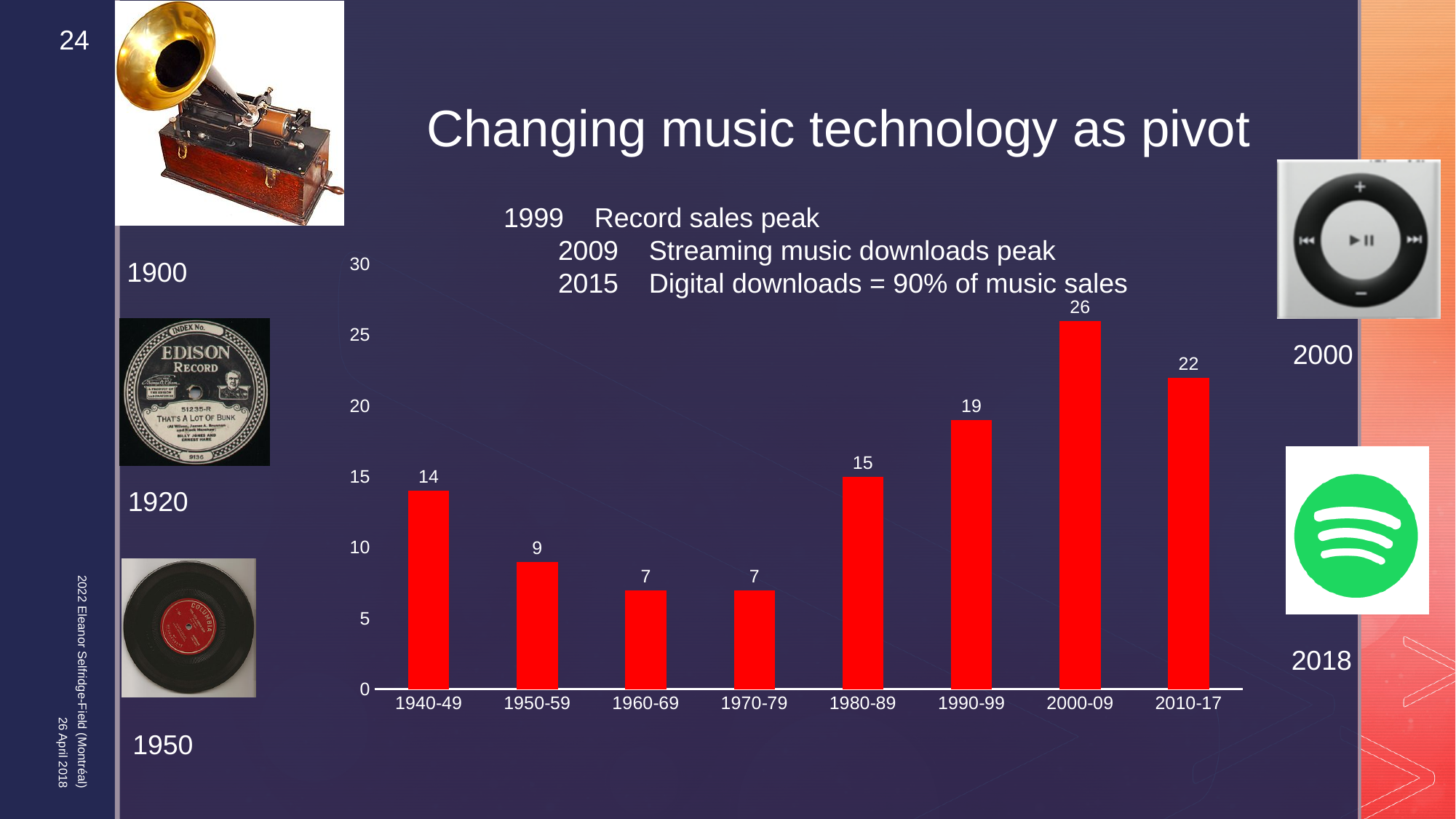
How many decade categories are shown on the x axis? 8 What is the difference between the values for 2000-09 and 1980-89? 11 Is the value for 2000-09 greater or less than 25? greater Do the values rise or fall from 1970-79 to 2000-09? rise What colour are the bars in the chart? red Which decade has the highest value? 2000-09 What is the total of the values for 1960-69 and 1970-79? 14 What is the value for 1940-49? 14 Which is larger, the value for 1950-59 or the value for 1980-89? 1980-89 What kind of chart is shown on the slide? bar chart What is the value for 1990-99? 19 What is the value for 2010-17? 22